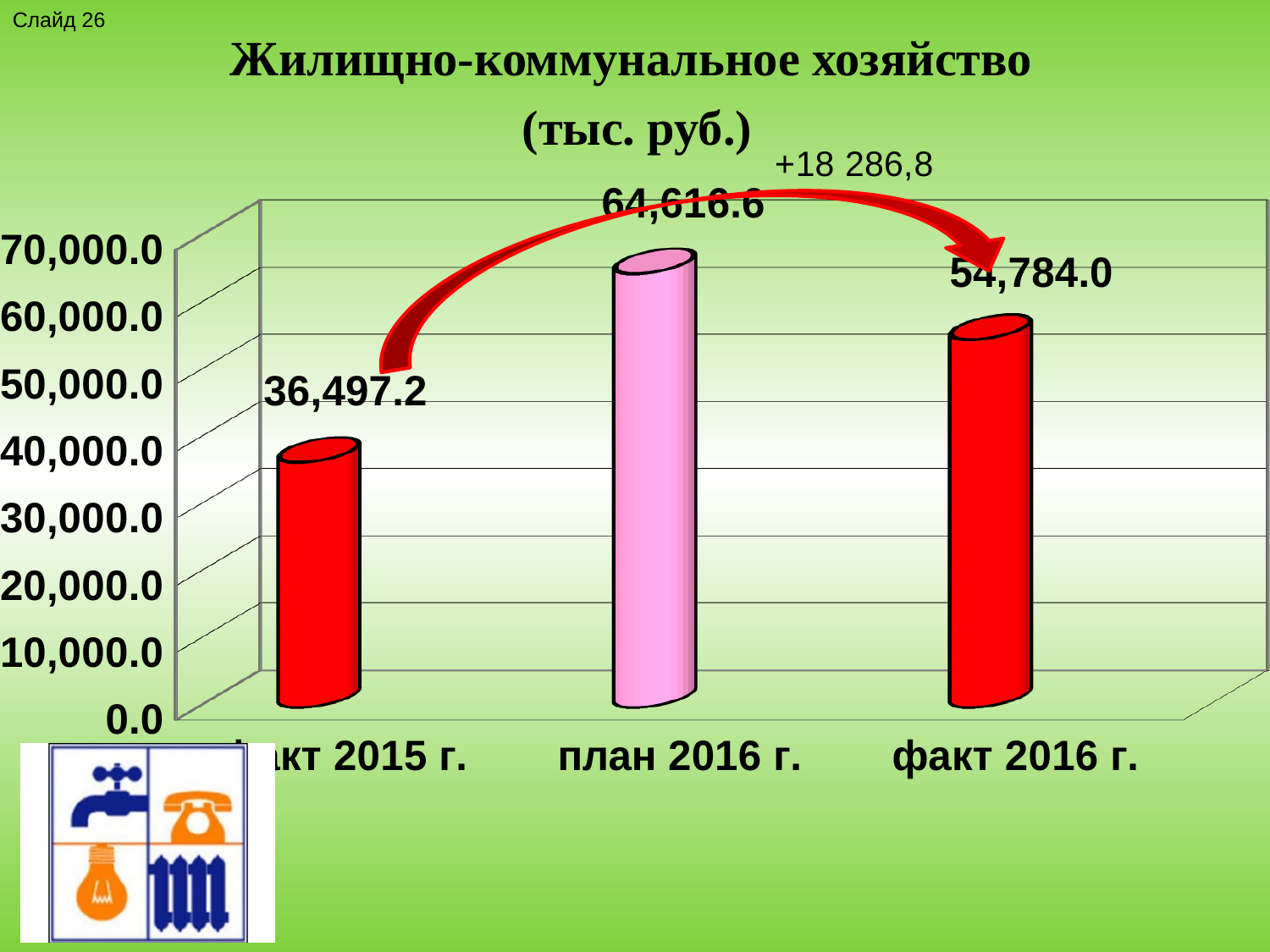
Is the value for факт 2016 г. greater or less than 60,000.0? less What is the difference between the values for факт 2016 г. and факт 2015 г.? 18,286.8 What colour is the bar for план 2016 г.? pink What is the title of the chart? Жилищно-коммунальное хозяйство (тыс. руб.) Which category has the highest value? план 2016 г. Which category has the lowest value? факт 2015 г. What is the value for факт 2015 г.? 36,497.2 Which is larger, the value for план 2016 г. or the value for факт 2016 г.? план 2016 г. What is the value for факт 2016 г.? 54,784.0 How many categories are shown on the chart? 3 What kind of chart is shown on the slide? bar chart Is the value for план 2016 г. greater or less than 60,000.0? greater